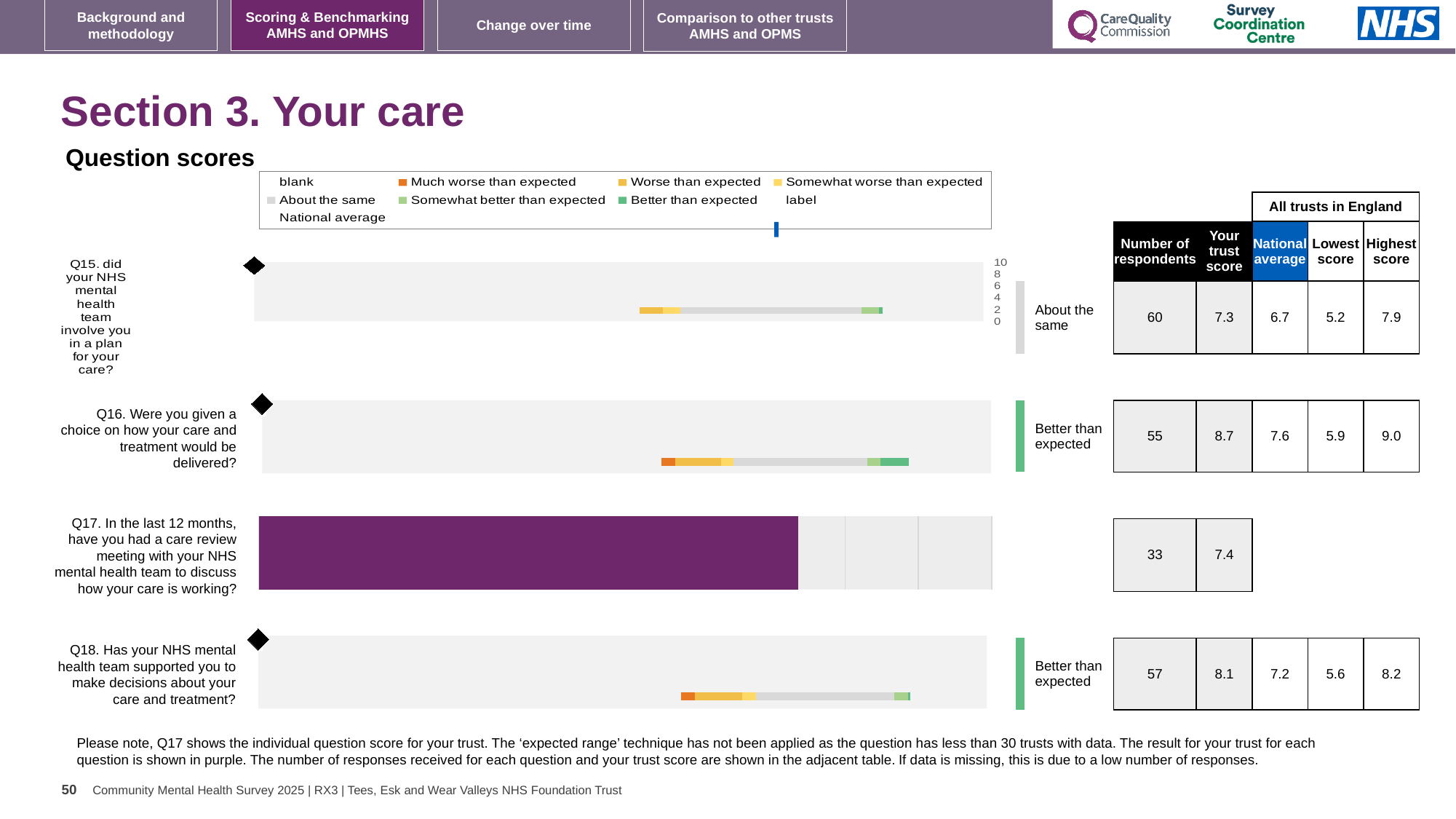
What is the lowest score across all trusts in England for Q15? 5.2 What kind of chart is used to show the question scores? Bar chart How many questions are plotted on this slide? 4 Which question's bar is shown in purple because the expected range technique was not applied? Q17 Which question has the lowest number of respondents? Q17 What is the difference between the trust score and the national average for Q16? 1.1 What is the highest score across all trusts in England for Q18? 8.2 For Q15, which is larger: the trust score or the national average? Trust score What is the national average for Q18 (Has your NHS mental health team supported you to make decisions about your care and treatment)? 7.2 How many respondents answered Q15 (did your NHS mental health team involve you in a plan for your care)? 60 What is the trust score for Q16 (Were you given a choice on how your care and treatment would be delivered)? 8.7 Which question has the highest trust score on this slide? Q16